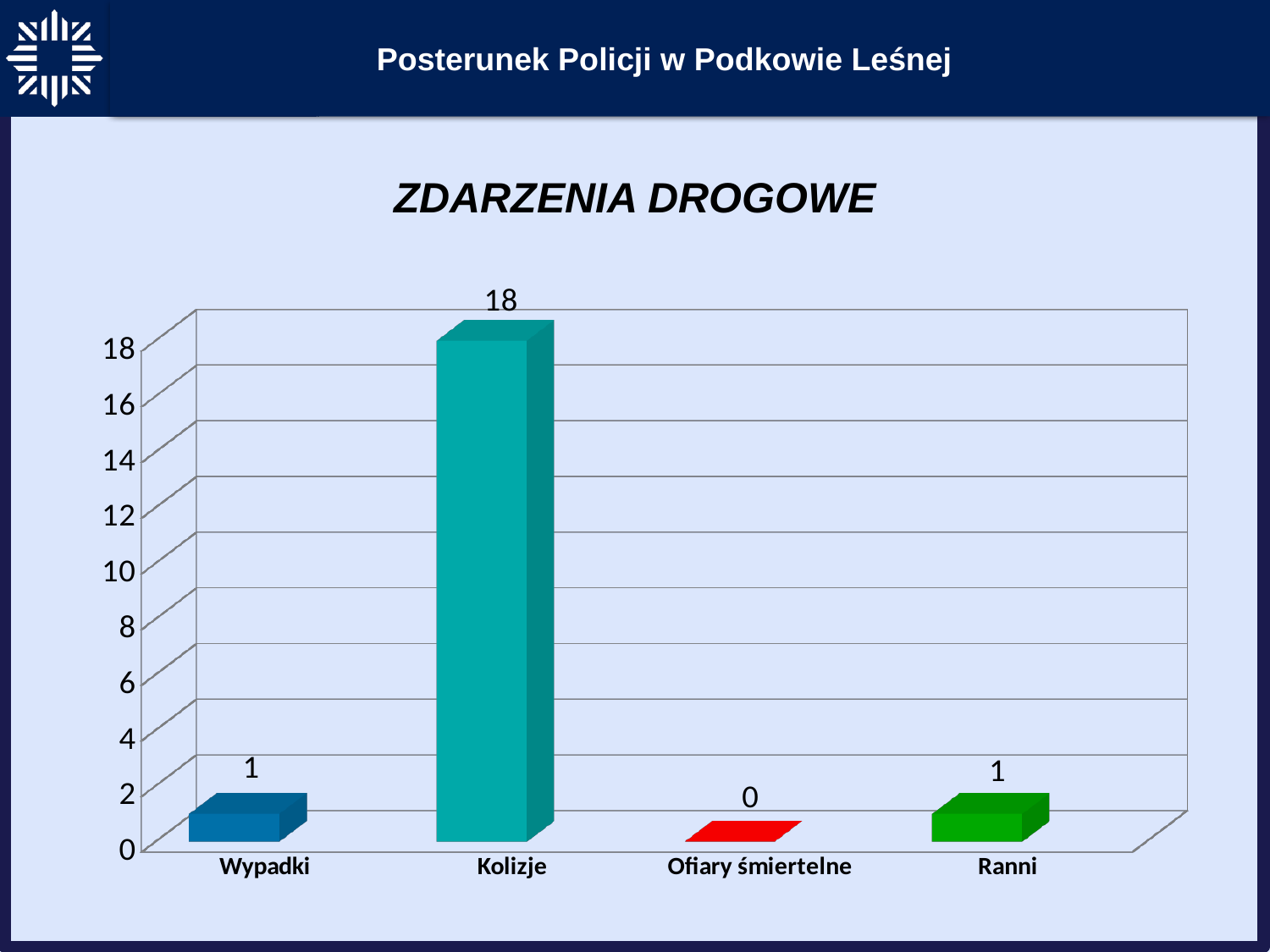
How many categories are shown on the chart? 4 What is the difference between the values for Kolizje and Wypadki? 17 What is the value for Wypadki? 1 What kind of chart is shown on the slide? bar chart What is the value for Kolizje? 18 What is the title of the chart? ZDARZENIA DROGOWE What is the value for Ranni? 1 Which category has the highest value? Kolizje Which is larger, the value for Kolizje or the value for Ranni? Kolizje Is the value for Kolizje greater or less than 10? greater What is the value for Ofiary śmiertelne? 0 Which category has the lowest value? Ofiary śmiertelne